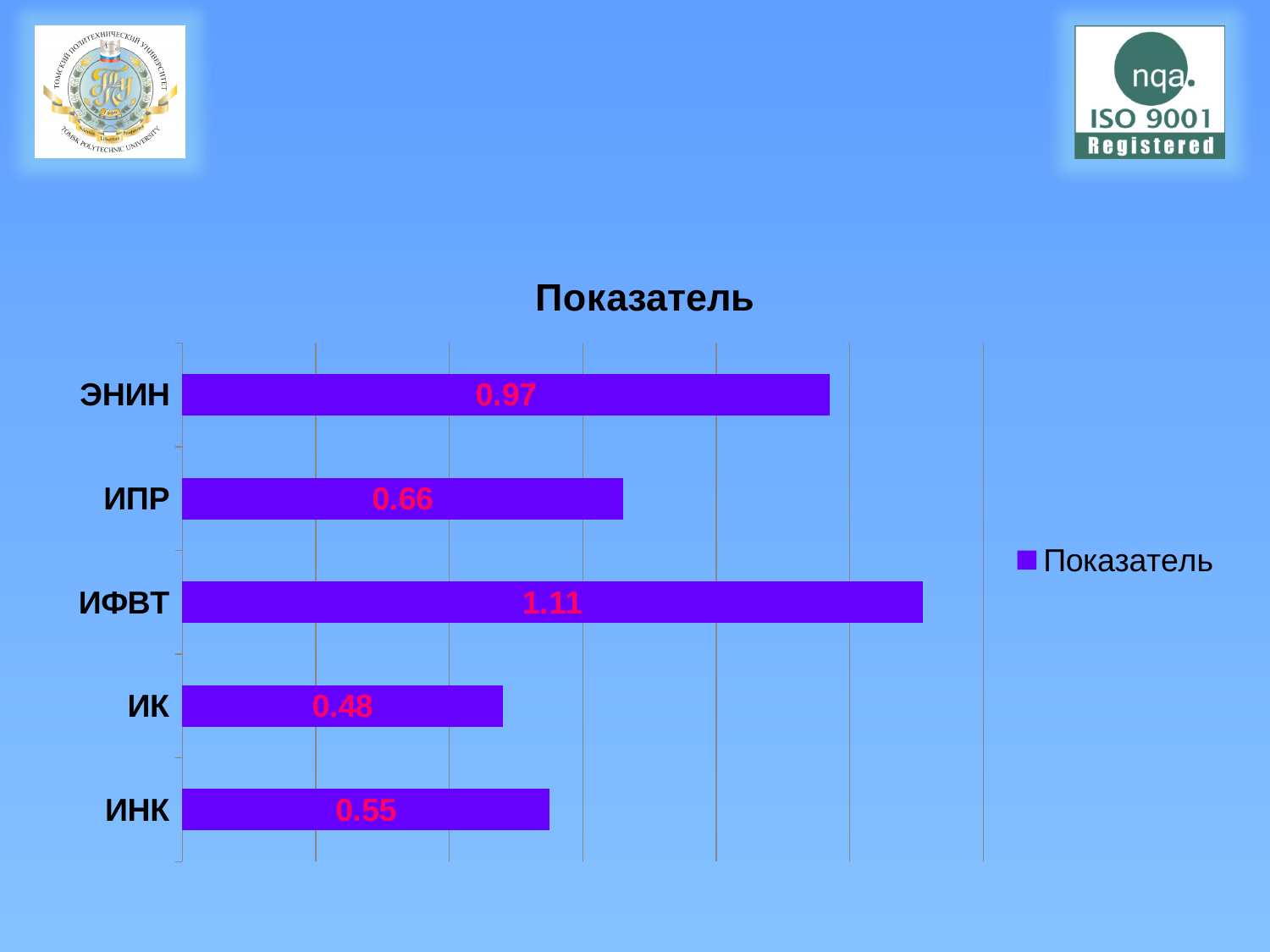
What is the value for ИФВТ? 1.11 What is the difference between the values for ЭНИН and ИНК? 0.42 What is the difference between the values for ИФВТ and ИПР? 0.45 Which is larger, the value for ИПР or the value for ИНК? ИПР What is the value for ИК? 0.48 What is the value for ИНК? 0.55 What is the value for ЭНИН? 0.97 Which category has the highest value? ИФВТ What is the title of the chart? Показатель Which category has the lowest value? ИК How many categories are shown in the chart? 5 What kind of chart is shown on the slide? Bar chart